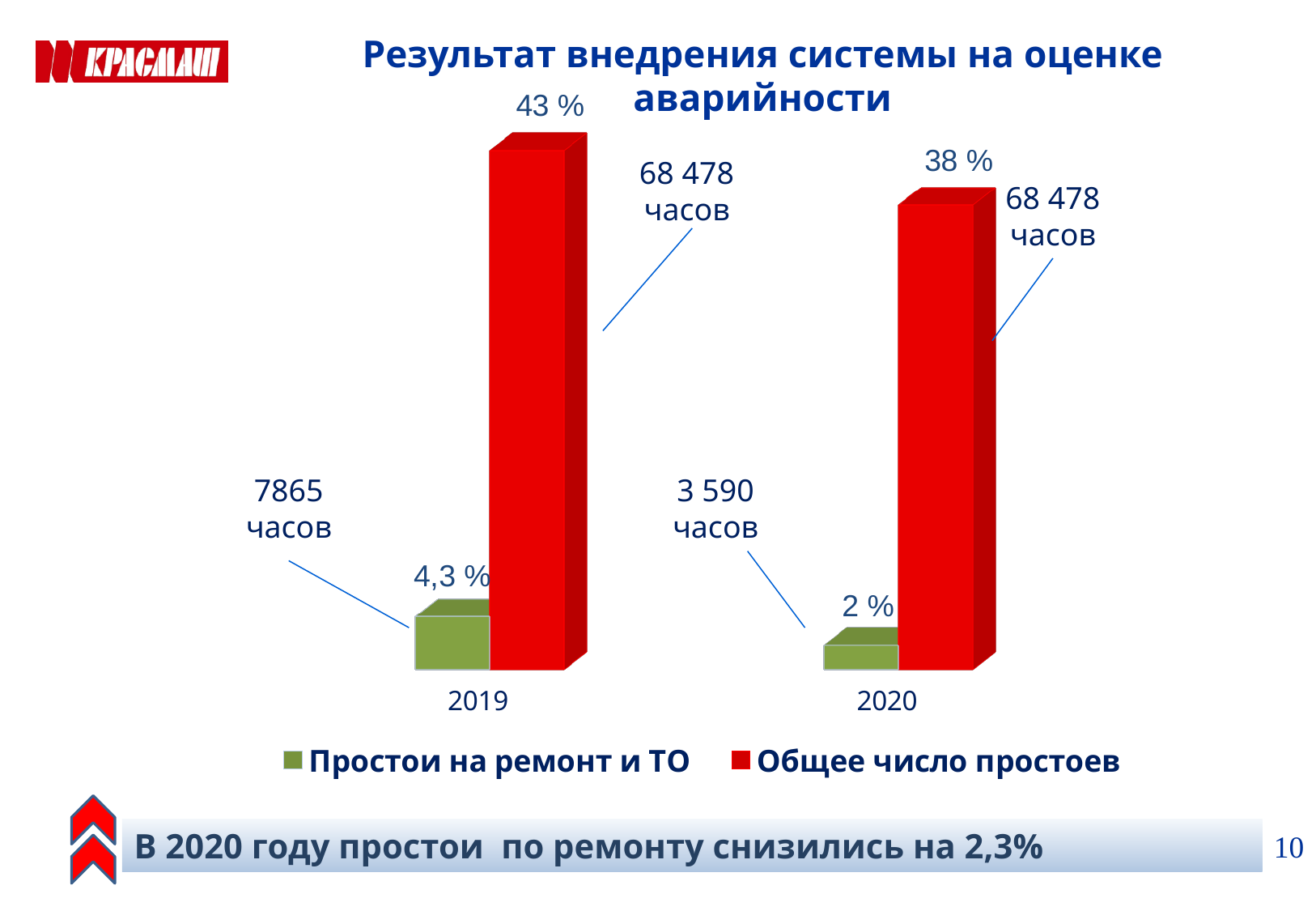
How many categories (years) are shown on the x axis? 2 How many hours are annotated for 'Простои на ремонт и ТО' in 2020? 3 590 часов What is the data label on the 'Общее число простоев' bar for 2019? 43 % What is the data label on the 'Общее число простоев' bar for 2020? 38 % Which year has the higher value for 'Общее число простоев', 2019 or 2020? 2019 Does the 'Простои на ремонт и ТО' value rise or fall from 2019 to 2020? fall What kind of chart is shown on the slide? bar chart What colour are the 'Общее число простоев' bars? red How many series does the legend list? 2 What is the data label on the 'Простои на ремонт и ТО' bar for 2020? 2 % How many hours are annotated for 'Простои на ремонт и ТО' in 2019? 7865 часов What is the data label on the 'Простои на ремонт и ТО' bar for 2019? 4,3 %